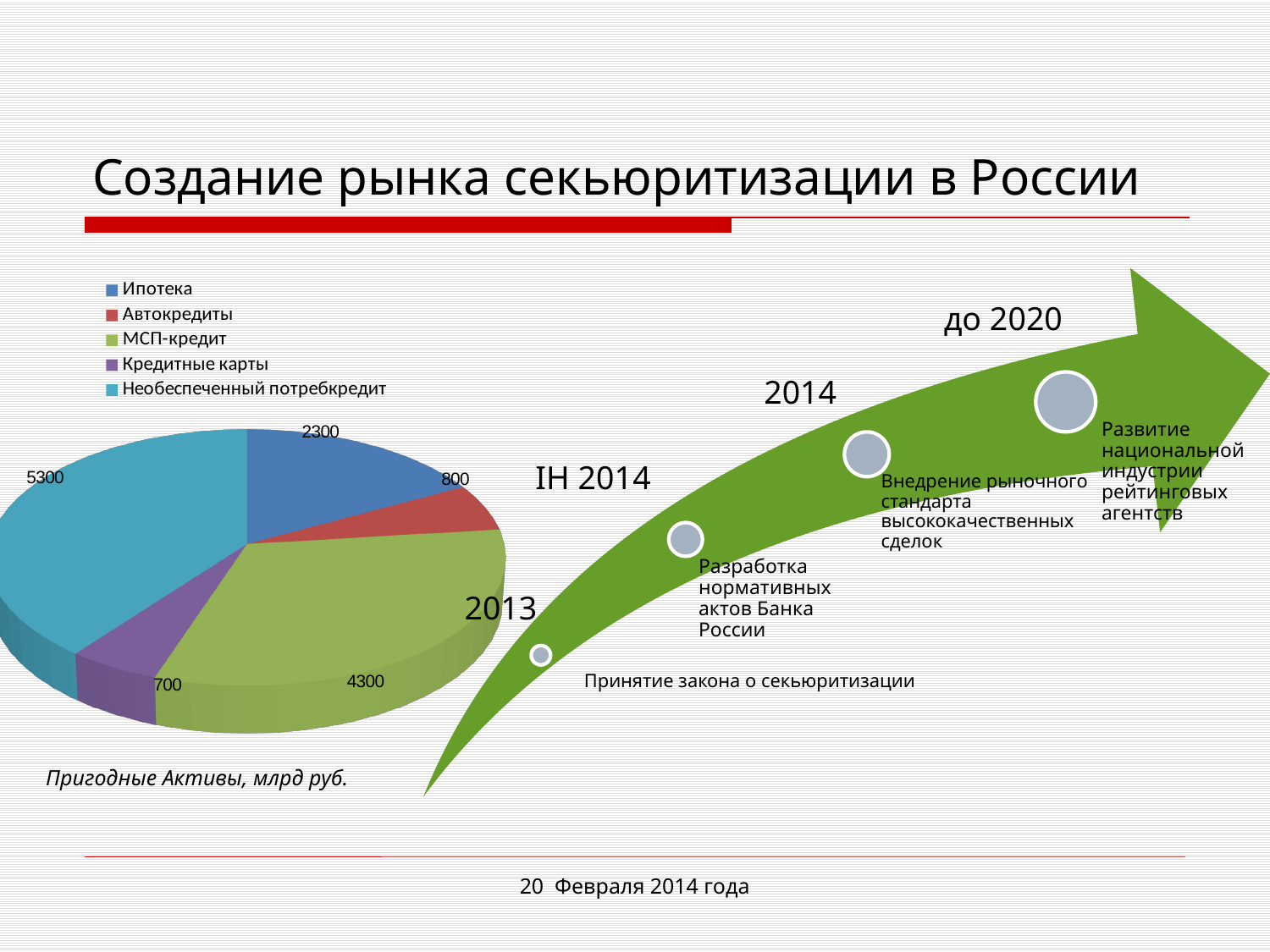
What is the value for Ипотека in the pie chart? 2300 Which category has the largest slice in the pie chart? Необеспеченный потребкредит What is the value for Необеспеченный потребкредит in the pie chart? 5300 How many categories does the pie chart show? 5 What is the difference between the values for Необеспеченный потребкредит and МСП-кредит? 1000 Which is larger, the value for Ипотека or the value for Автокредиты? Ипотека What is the value for Автокредиты in the pie chart? 800 Which category has the smallest slice in the pie chart? Кредитные карты What is the value for Кредитные карты in the pie chart? 700 What is the value for МСП-кредит in the pie chart? 4300 What is the total of all the values shown in the pie chart? 13400 What kind of chart is shown on the left of the slide? Pie chart